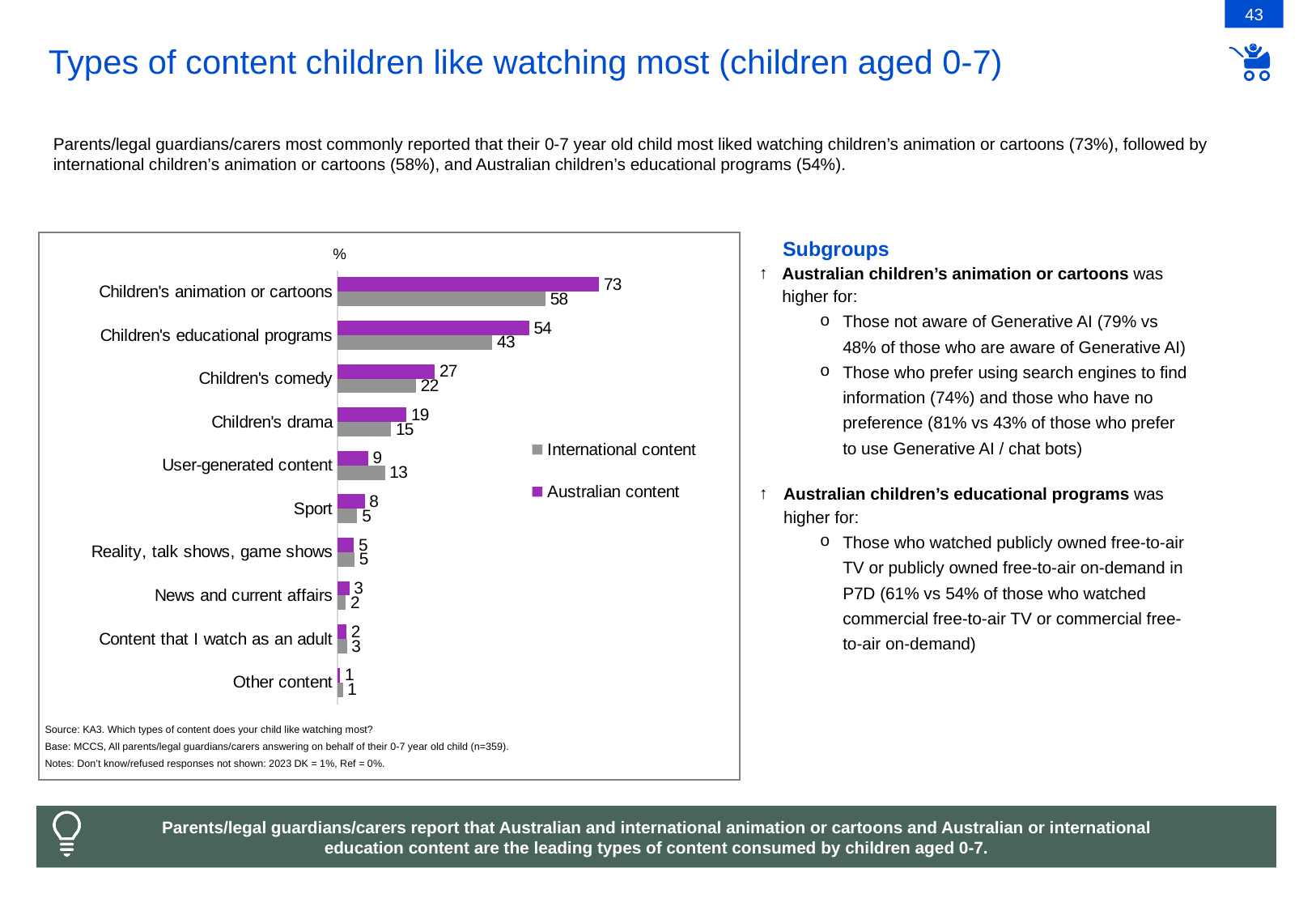
Which category has the lowest International content value? Other content What is the Australian content value for Children's comedy? 27 How many content categories are shown in the chart? 10 What is the Australian content value for Children's animation or cartoons? 73 What is the International content value for Children's educational programs? 43 What is the International content value for User-generated content? 13 What is the difference between the Australian content and International content values for Children's animation or cartoons? 15 Which category has the highest Australian content value? Children's animation or cartoons What kind of chart is shown on the slide? Bar chart What colour represents Australian content in the chart? Purple How many series does the legend list? 2 For User-generated content, which is larger: Australian content or International content? International content